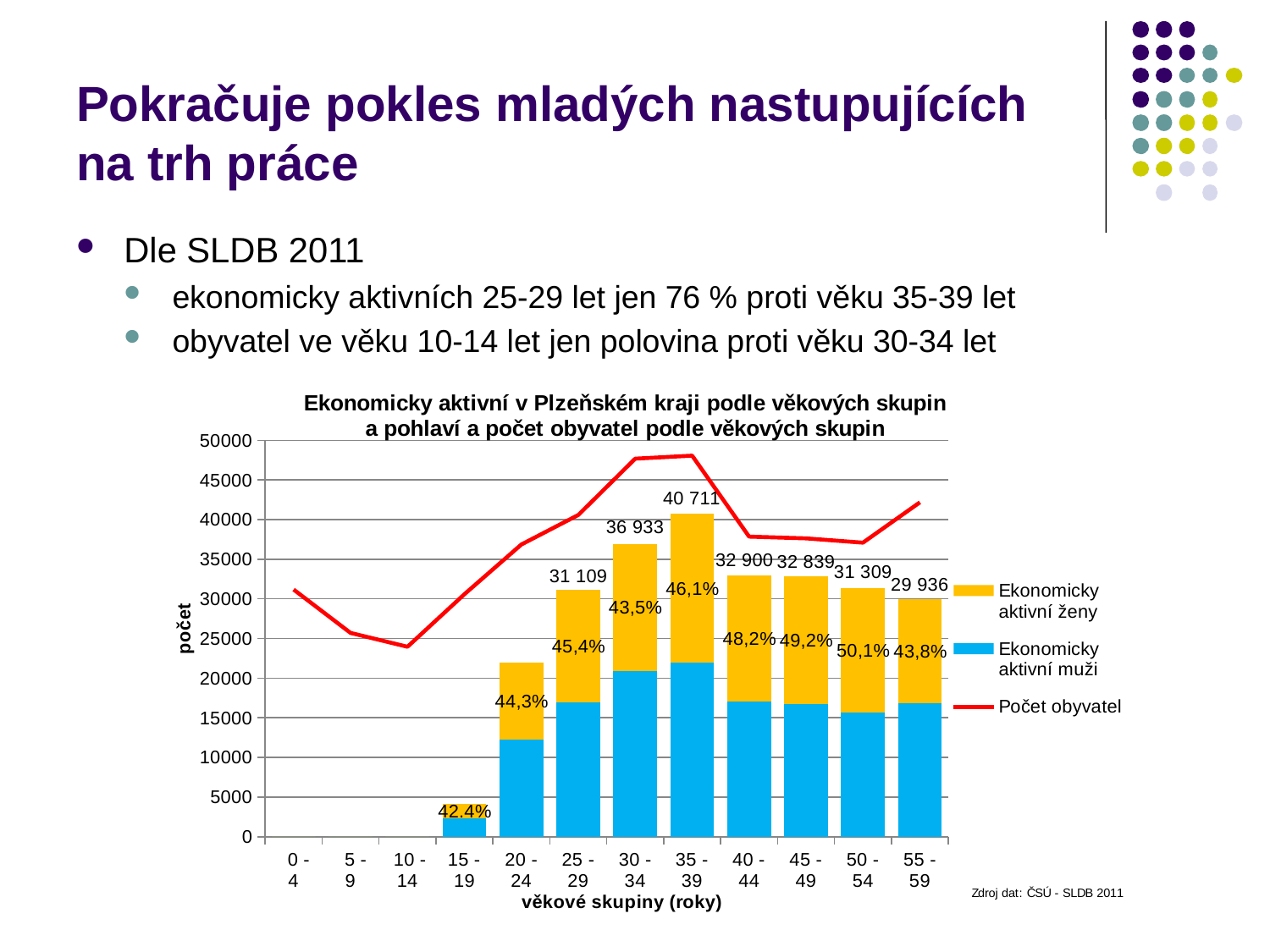
Which age group has the highest stacked bar? 35 - 39 What percentage label is shown on the bar for the 45 - 49 age group? 49,2% How many series does the legend list? 3 What is the total labelled on the bar for the 35 - 39 age group? 40 711 What kind of chart is shown on the slide? stacked bar chart with a line How many age groups are shown on the x axis? 12 Does the Počet obyvatel line rise or fall from the 0 - 4 group to the 10 - 14 group? fall What is the total labelled on the bar for the 30 - 34 age group? 36 933 Is the Počet obyvatel value for the 30 - 34 age group greater or less than 45000? greater Which has the larger total, the 30 - 34 bar or the 50 - 54 bar? 30 - 34 What is the difference between the totals for the 35 - 39 and 30 - 34 age groups? 3 778 Among the bars with a printed total, which age group has the lowest total? 55 - 59